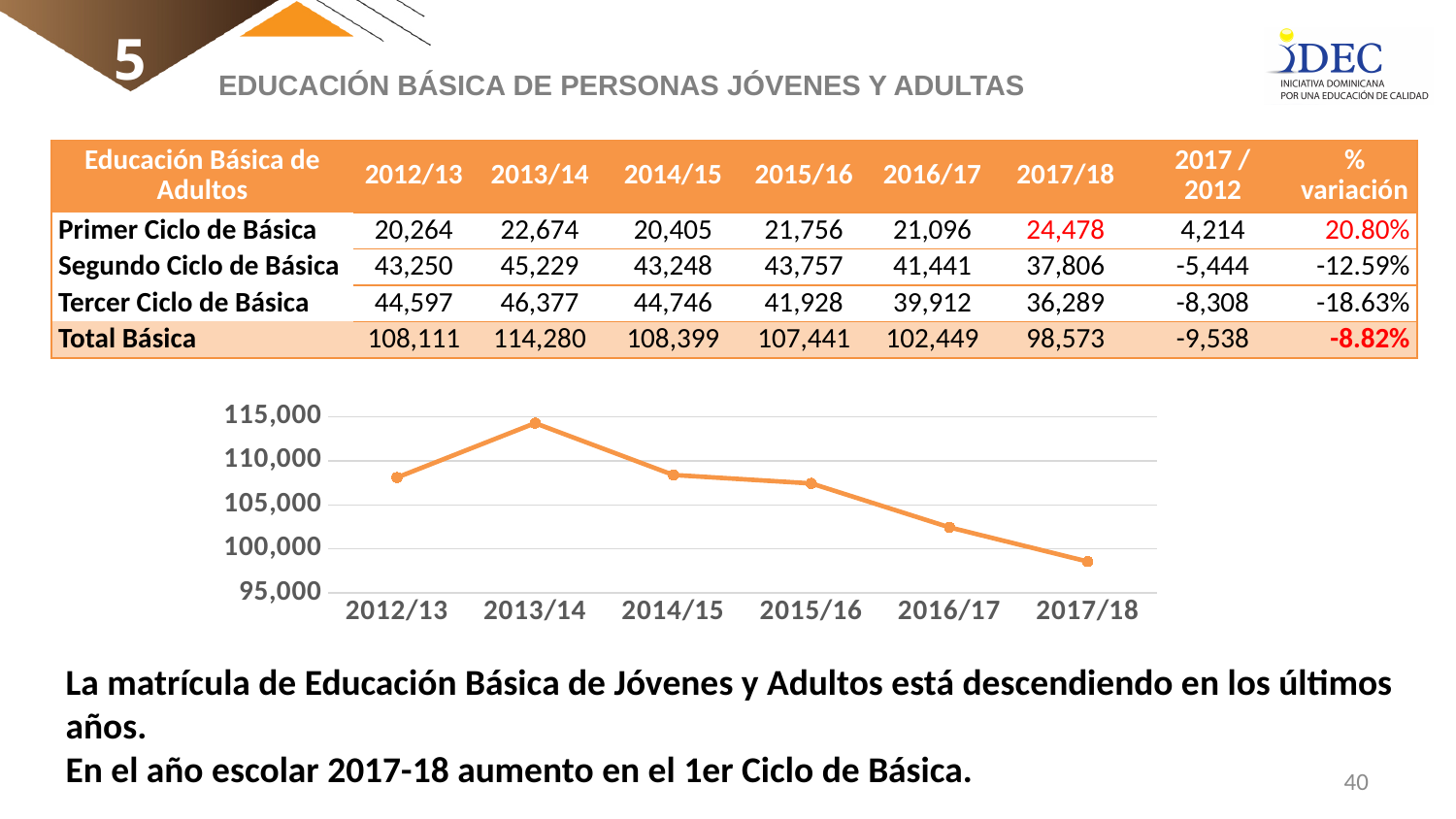
Is the value for 2017/18 in the line chart greater or less than 100,000? less What is the lowest tick value shown on the y axis of the line chart? 95,000 According to the table, what is the Total Básica value for 2013/14, the peak of the line chart? 114,280 Is the value for 2016/17 in the line chart greater or less than 105,000? less How many school years are plotted on the x axis of the line chart? 6 Is the value for 2013/14 in the line chart greater or less than 110,000? greater In the line chart, which is larger, the value for 2014/15 or the value for 2016/17? 2014/15 What kind of chart is shown on the slide? line chart From 2013/14 to 2017/18, do the values in the line chart rise or fall? fall In the line chart, which school year has the lowest value? 2017/18 In the line chart, which school year has the highest value? 2013/14